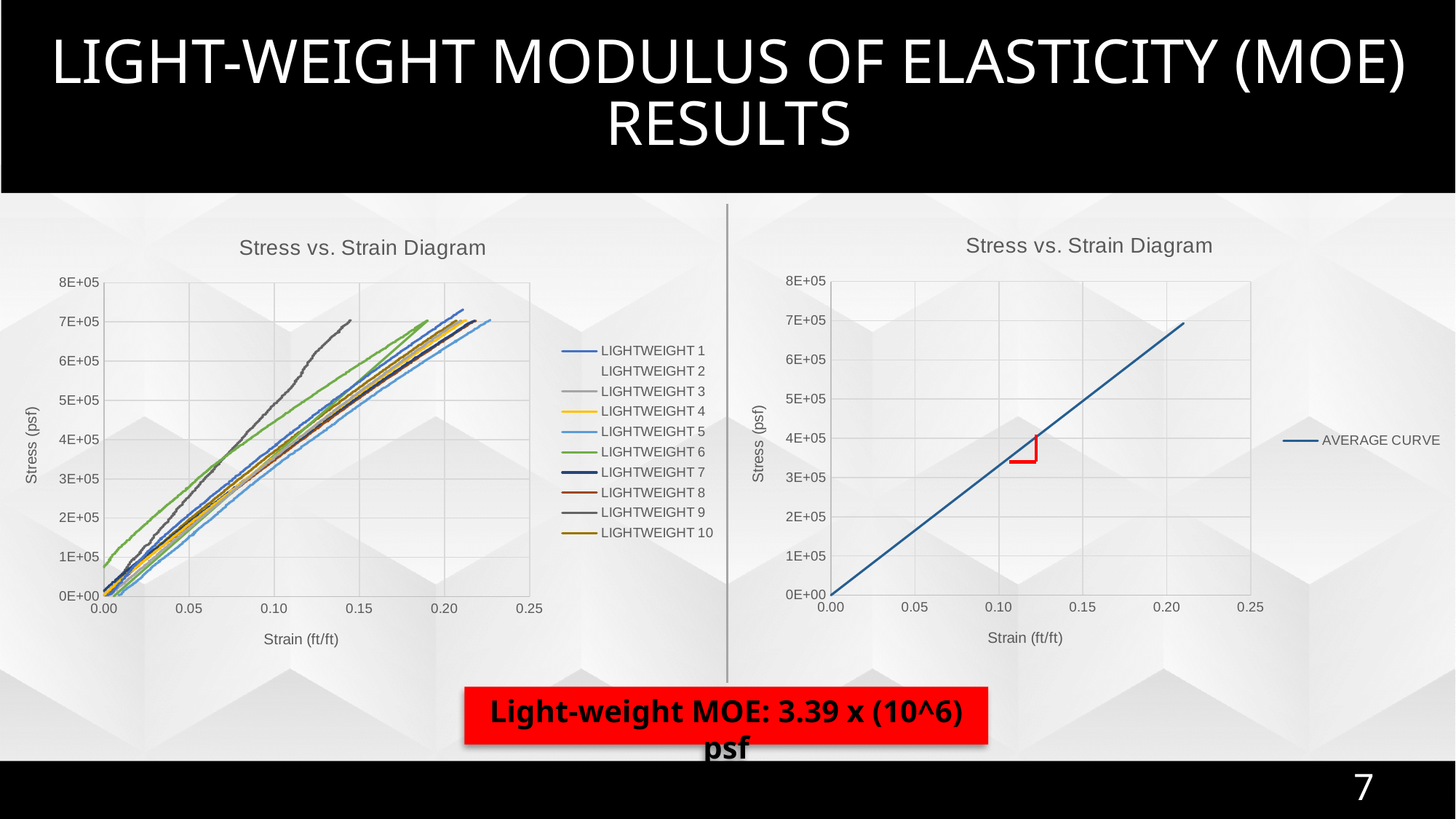
How many series does the legend of the right chart list? 1 In the left chart, do the stress values rise or fall as strain increases along the x axis? rise In the right chart, is the stress of the AVERAGE CURVE at a strain of 0.20 greater or less than 6E+05? greater What is the highest tick value shown on the y axis of the left chart? 8E+05 What is the name of the series plotted in the right chart? AVERAGE CURVE How many series does the legend of the left chart list? 10 In the right chart, does stress rise or fall as strain increases along the x axis? rise What is the title of the right chart? Stress vs. Strain Diagram What is the highest tick value shown on the x axis of the right chart? 0.25 In the right chart, is the stress of the AVERAGE CURVE at a strain of 0.20 greater or less than 7E+05? less In the left chart, which series reaches a stress of 7E+05 at the smallest strain? LIGHTWEIGHT 9 What type of chart is the left chart on the slide? line chart